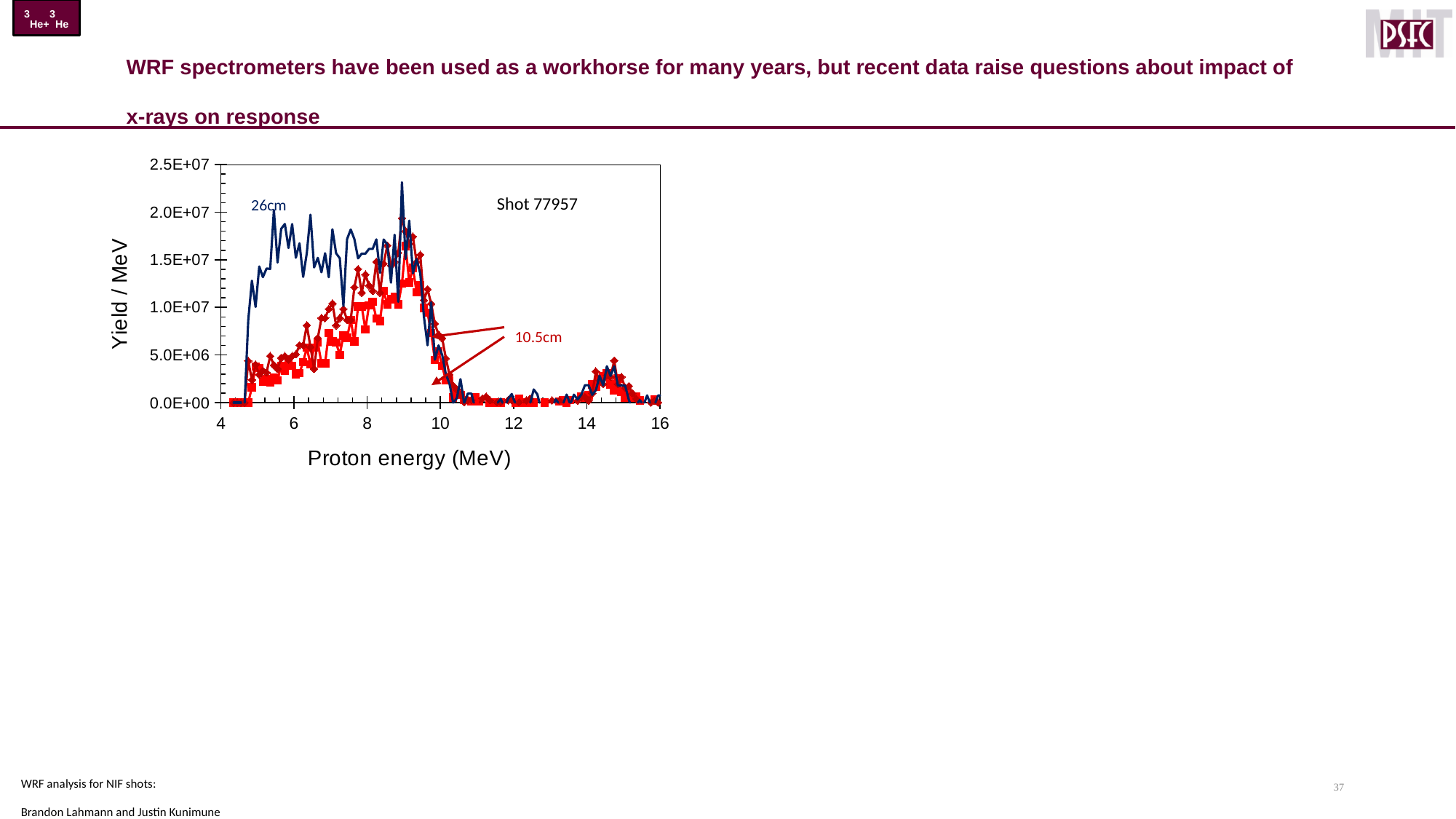
Between proton energies of 6 MeV and 9 MeV, does the 10.5cm series rise or fall overall? rise What is the label of the y axis of the chart? Yield / MeV What kind of chart is shown on the slide? line chart Is the peak value of the 26cm series near 9 MeV greater or less than 2.0E+07? greater Is the value of the 26cm series at a proton energy of 8 MeV greater or less than 1.0E+07? greater Between proton energies of 10 MeV and 11 MeV, do the yield values rise or fall? fall Is the value of the 26cm series at a proton energy of 12 MeV greater or less than 5.0E+06? less What is the label of the x axis of the chart? Proton energy (MeV) At a proton energy of 6 MeV, which series has the larger yield, 26cm or 10.5cm? 26cm Which series reaches the highest yield on the chart? 26cm